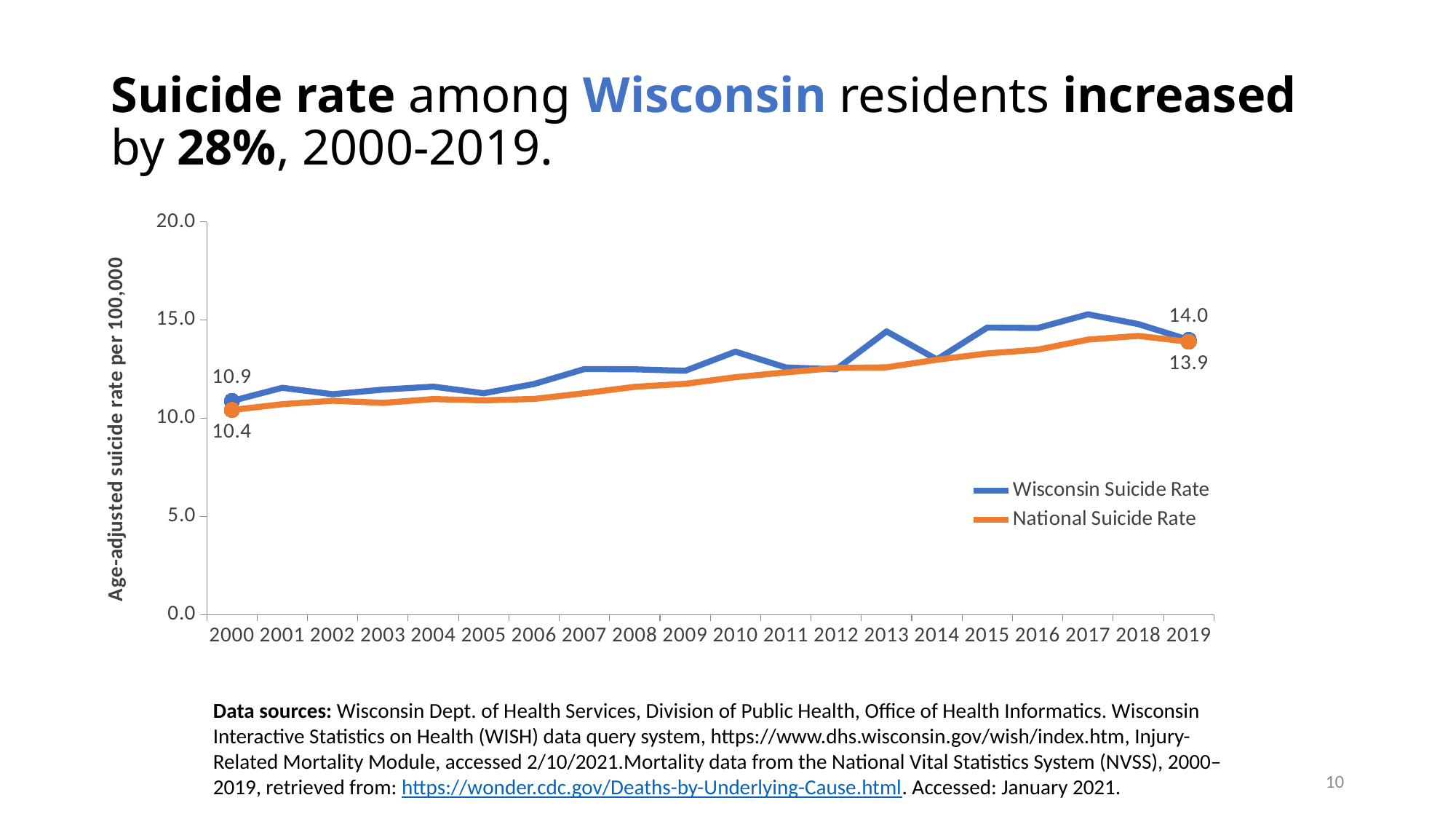
How many series does the chart's legend list? 2 What type of chart is shown on the slide? line chart By how much did the Wisconsin suicide rate increase from 2000 to 2019? 3.1 Is the Wisconsin suicide rate in 2013 greater or less than 15.0? less What was the national suicide rate in 2019? 13.9 What was the Wisconsin suicide rate in 2019? 14.0 What is the difference between the Wisconsin and national suicide rates in 2000? 0.5 In which year was the Wisconsin suicide rate highest? 2017 What was the Wisconsin suicide rate in 2000? 10.9 How many years are shown on the x axis of the chart? 20 In 2000, which was higher: the Wisconsin suicide rate or the national suicide rate? Wisconsin Suicide Rate In which year was the national suicide rate lowest? 2000